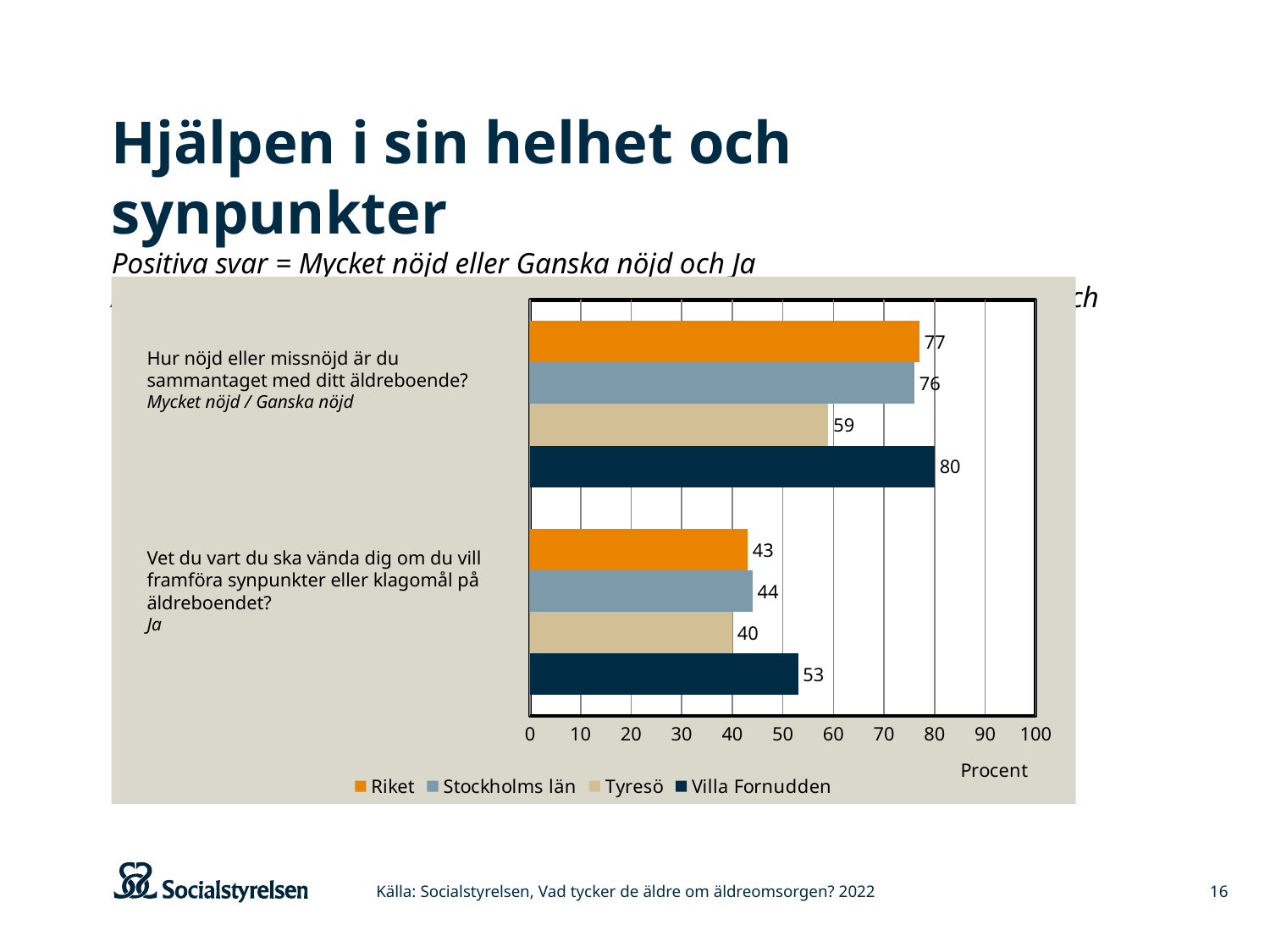
Which series has the lowest value on the question "Hur nöjd eller missnöjd är du sammantaget med ditt äldreboende?"? Tyresö What unit label is shown on the x axis of the chart? Procent What is the value for Villa Fornudden on the question "Hur nöjd eller missnöjd är du sammantaget med ditt äldreboende?"? 80 Which series has the highest value on the question "Vet du vart du ska vända dig om du vill framföra synpunkter eller klagomål på äldreboendet?"? Villa Fornudden How many series does the legend list? 4 How many question categories are shown on the chart? 2 What is the difference between Villa Fornudden and Tyresö on the question "Hur nöjd eller missnöjd är du sammantaget med ditt äldreboende?"? 21 What kind of chart is shown on the slide? bar chart What is the value for Tyresö on the question "Vet du vart du ska vända dig om du vill framföra synpunkter eller klagomål på äldreboendet?"? 40 Which is larger on the question "Vet du vart du ska vända dig om du vill framföra synpunkter eller klagomål på äldreboendet?": Stockholms län or Tyresö? Stockholms län What is the difference between Villa Fornudden and Riket on the question "Vet du vart du ska vända dig om du vill framföra synpunkter eller klagomål på äldreboendet?"? 10 What is the value for Riket on the question "Hur nöjd eller missnöjd är du sammantaget med ditt äldreboende?"? 77